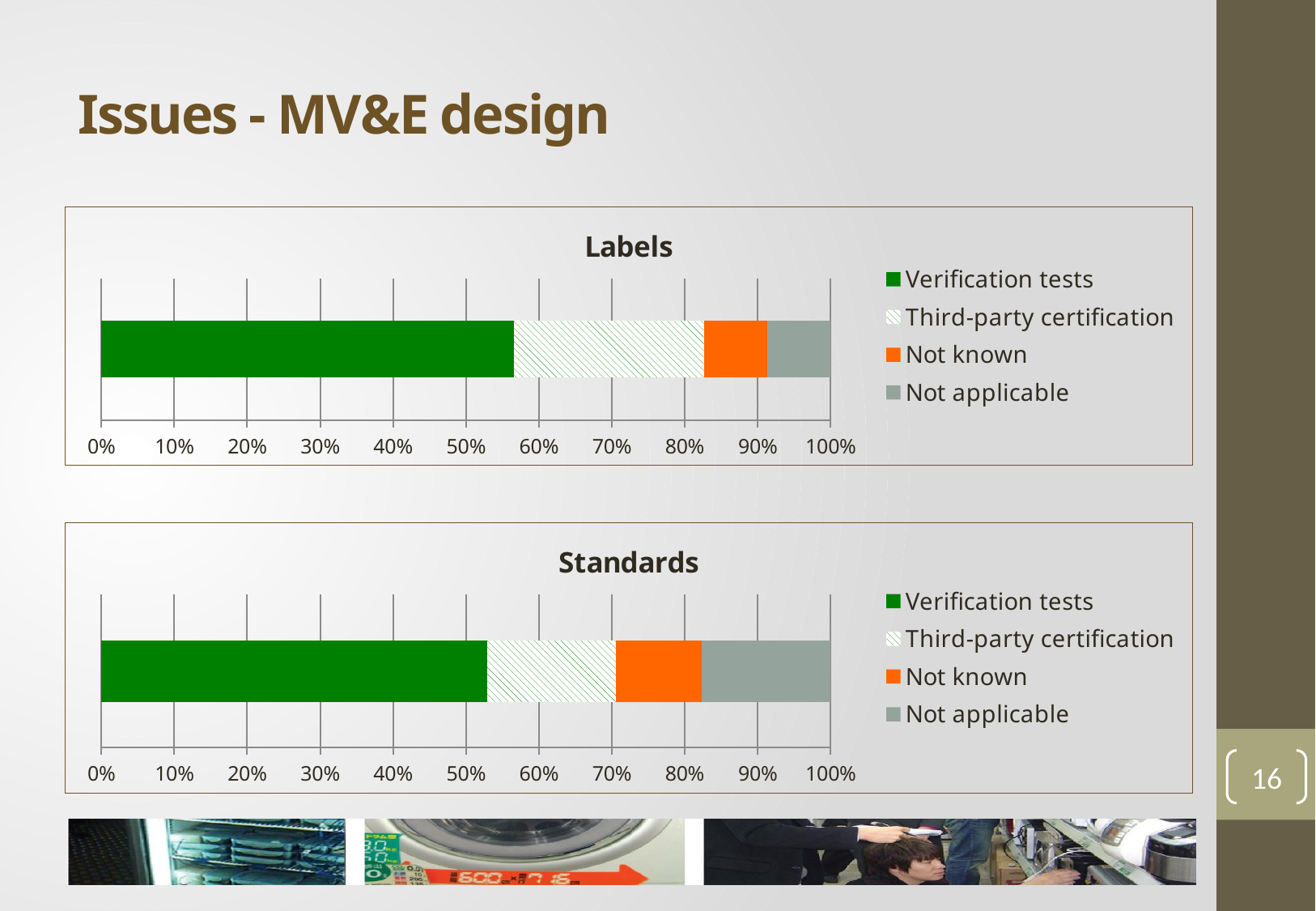
In the Standards chart, is the value for Verification tests greater or less than 60%? less How many series does the legend of the Standards chart list? 4 How many bars does the Standards chart contain? 1 What is the highest value shown on the x axis of the Standards chart? 100% In the Labels chart, is the value for Third-party certification greater or less than 10%? greater In the Labels chart, which is larger: Verification tests or Third-party certification? Verification tests In the Labels chart, which series takes up the largest share of the bar? Verification tests In the Labels chart, which series is shown in orange? Not known In the Labels chart, is the value for Verification tests greater or less than 50%? greater What kind of chart is the Labels chart? stacked bar chart In the Standards chart, which series takes up the largest share of the bar? Verification tests In the Standards chart, which is larger: Verification tests or Not applicable? Verification tests